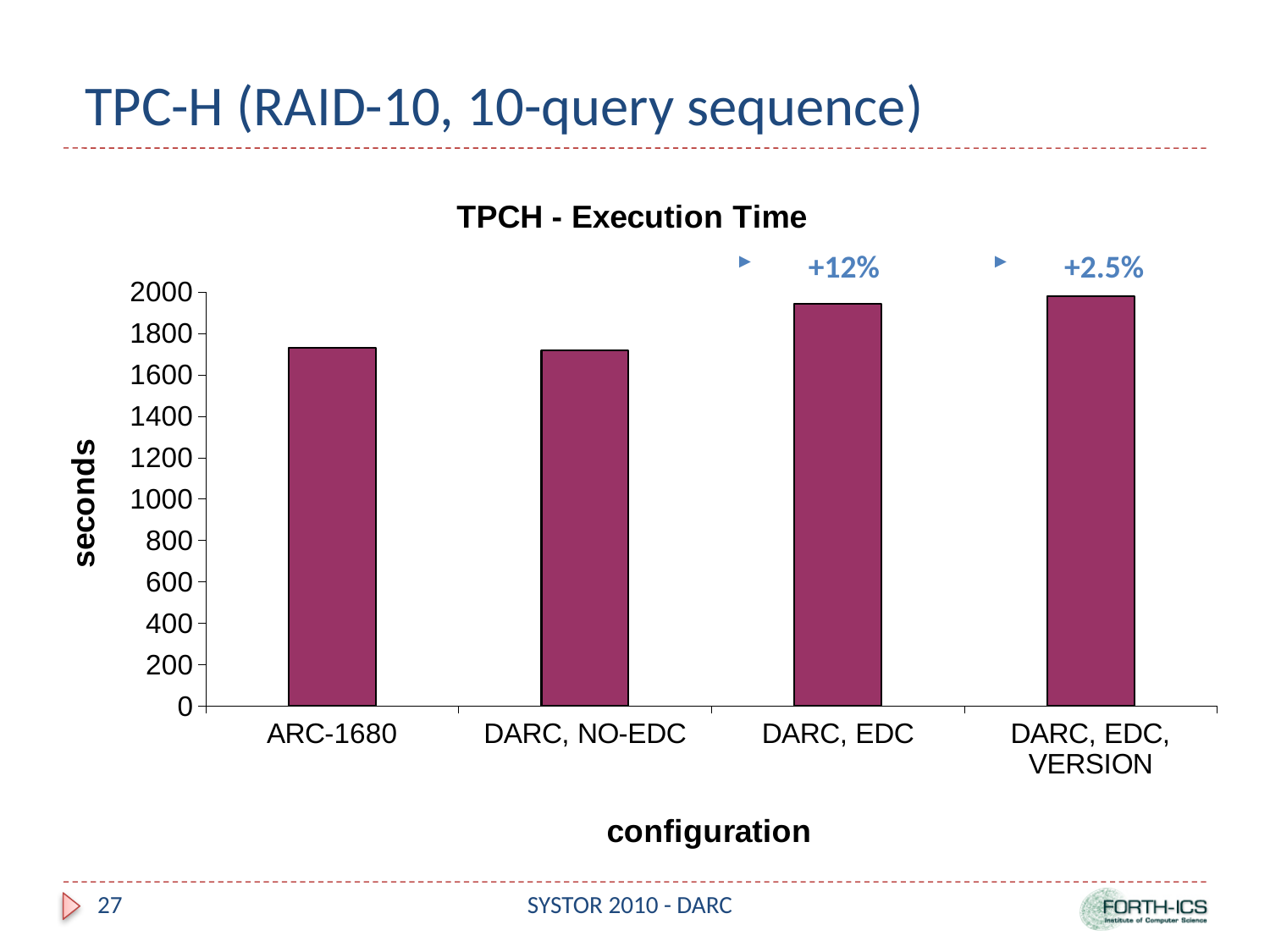
Which has the larger value, DARC, NO-EDC or DARC, EDC, VERSION? DARC, EDC, VERSION Which has the larger value, DARC, EDC or ARC-1680? DARC, EDC What kind of chart is shown on the slide? bar chart How many configurations are plotted on the x axis of the chart? 4 Is the value for ARC-1680 greater or less than 1600? greater Is the value for ARC-1680 greater or less than 1800? less Is the value for DARC, EDC greater or less than 1800? greater What is the label of the y axis of the chart? seconds What is the title of the chart? TPCH - Execution Time